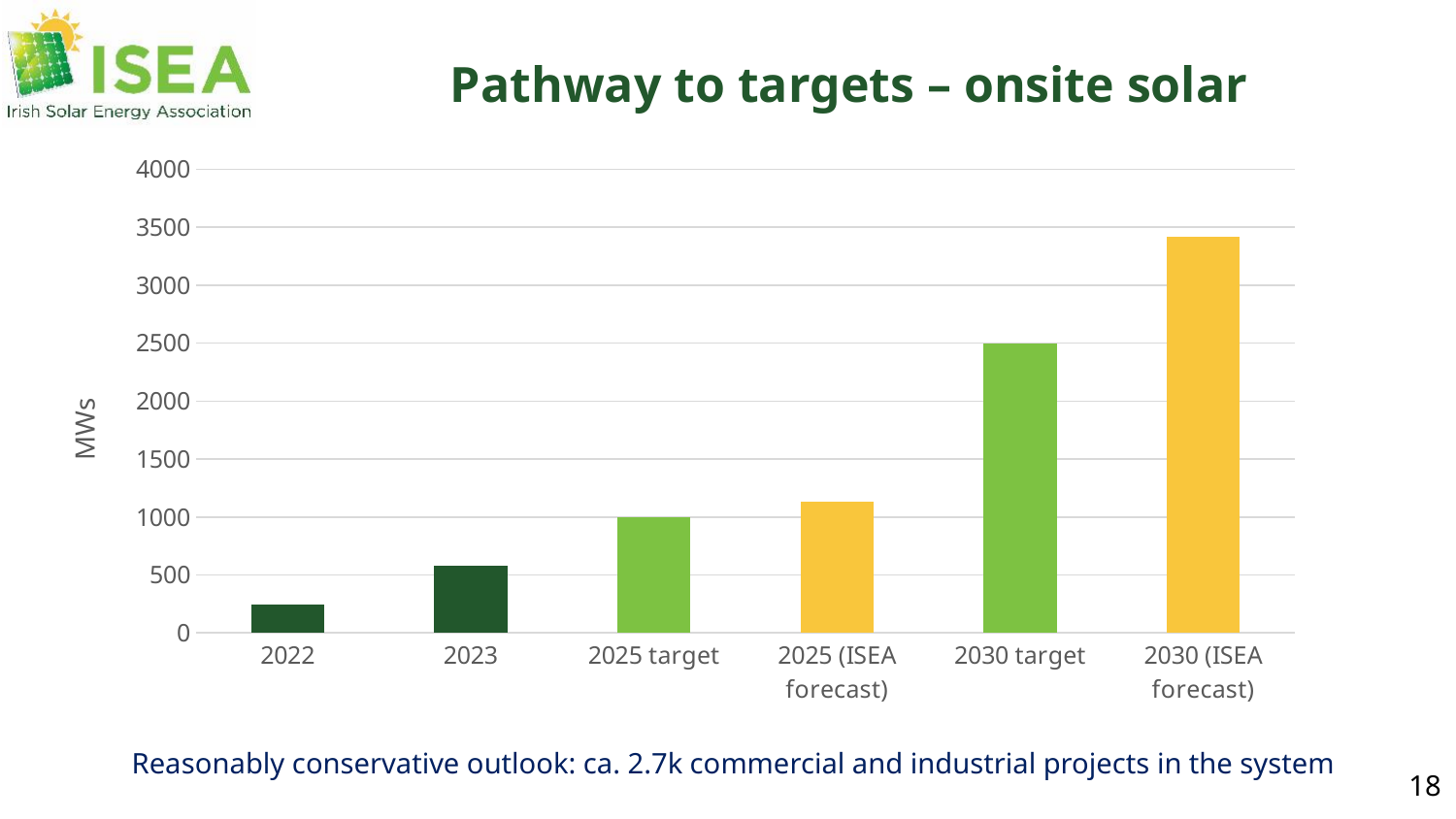
What is the value for 2030 target in MWs? 2500 Is the value for 2023 greater or less than 500? greater Which is larger, the value for 2030 target or the value for 2030 (ISEA forecast)? 2030 (ISEA forecast) How many categories are shown on the x axis of the chart? 6 Which category has the lowest value? 2022 Is the value for 2022 greater or less than 500? less What type of chart is shown on the slide? bar chart Which category has the highest value? 2030 (ISEA forecast) Is the value for 2025 (ISEA forecast) greater or less than 1000? greater What is the label on the vertical axis of the chart? MWs What is the value for 2025 target in MWs? 1000